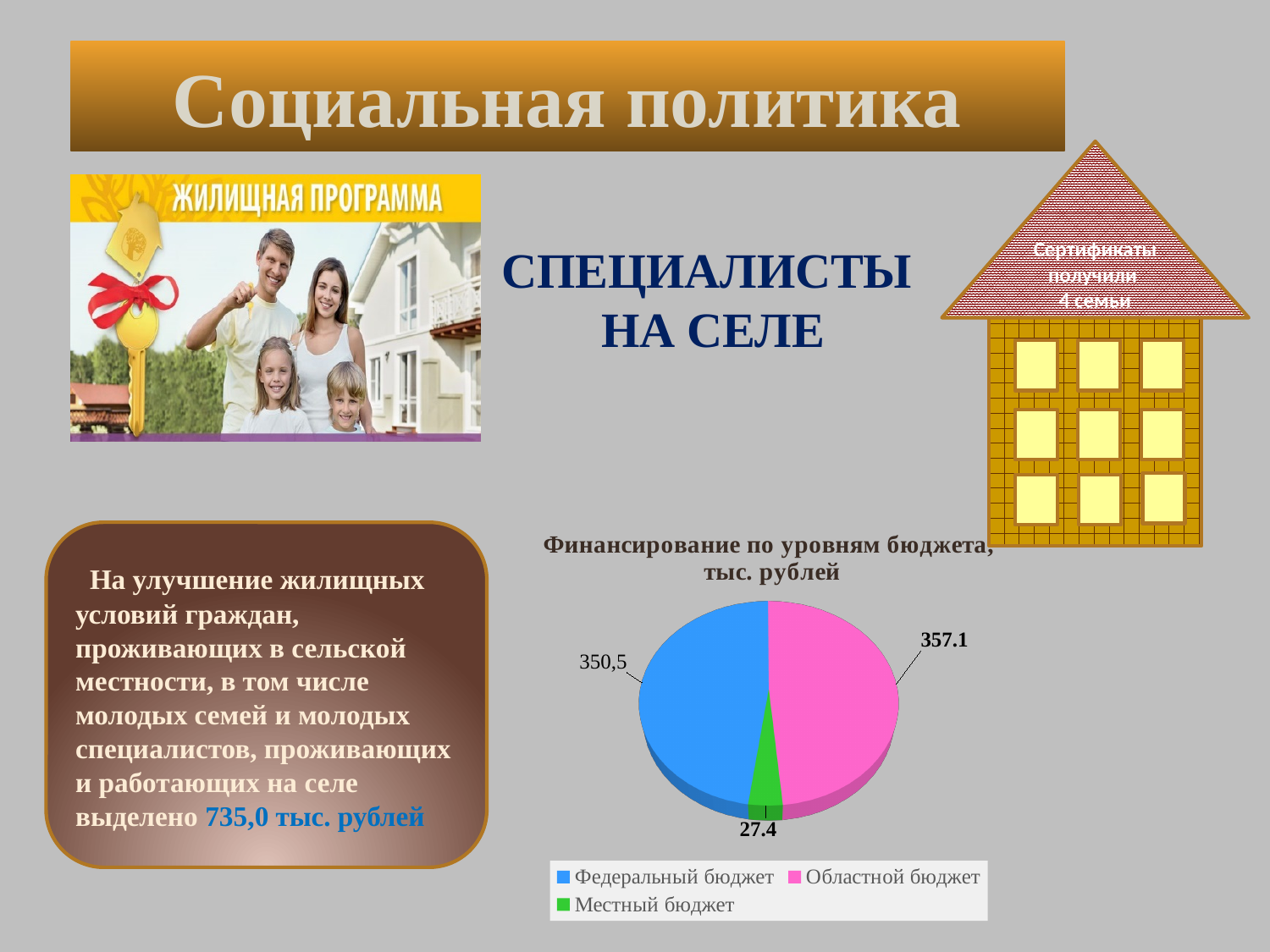
What kind of chart is shown on the slide? pie chart Which budget level has the largest slice in the pie chart? Областной бюджет How many series does the legend of the pie chart list? 3 Which is larger in the pie chart: Федеральный бюджет or Местный бюджет? Федеральный бюджет What is the title of the pie chart? Финансирование по уровням бюджета, тыс. рублей Which colour represents Местный бюджет in the pie chart? green What is the value for Федеральный бюджет in the pie chart? 350,5 Which budget level has the smallest slice in the pie chart? Местный бюджет What is the value for Местный бюджет in the pie chart? 27.4 How many slices does the pie chart have? 3 What is the difference between the values for Областной бюджет and Федеральный бюджет in the pie chart? 6.6 What is the value for Областной бюджет in the pie chart? 357.1